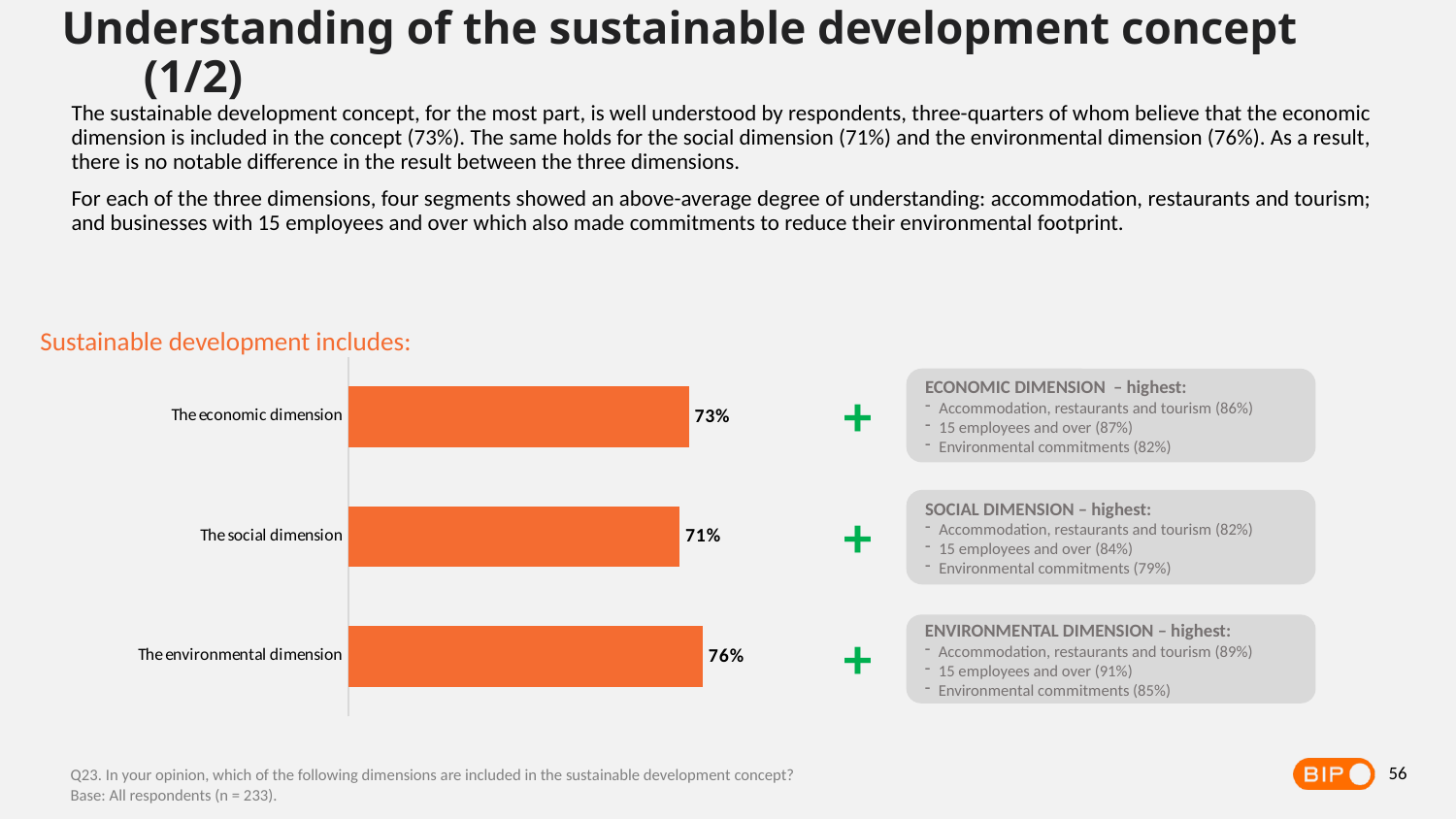
Which is larger, the value for the economic dimension or the value for the environmental dimension? The environmental dimension What is the difference in percentage points between the economic dimension and the social dimension? 2 percentage points Which dimension has the highest value in the chart? The environmental dimension What type of chart is used to show the dimensions? Bar chart What is the value shown for the social dimension? 71% What is the value shown for the environmental dimension? 76% What percentage of respondents believe the economic dimension is included in the sustainable development concept? 73% Which dimension has the lowest value in the chart? The social dimension What colour are the bars in the chart? Orange What is the difference in percentage points between the environmental dimension and the social dimension? 5 percentage points What is the title shown above the chart? Sustainable development includes: How many dimensions (categories) are plotted in the chart? 3